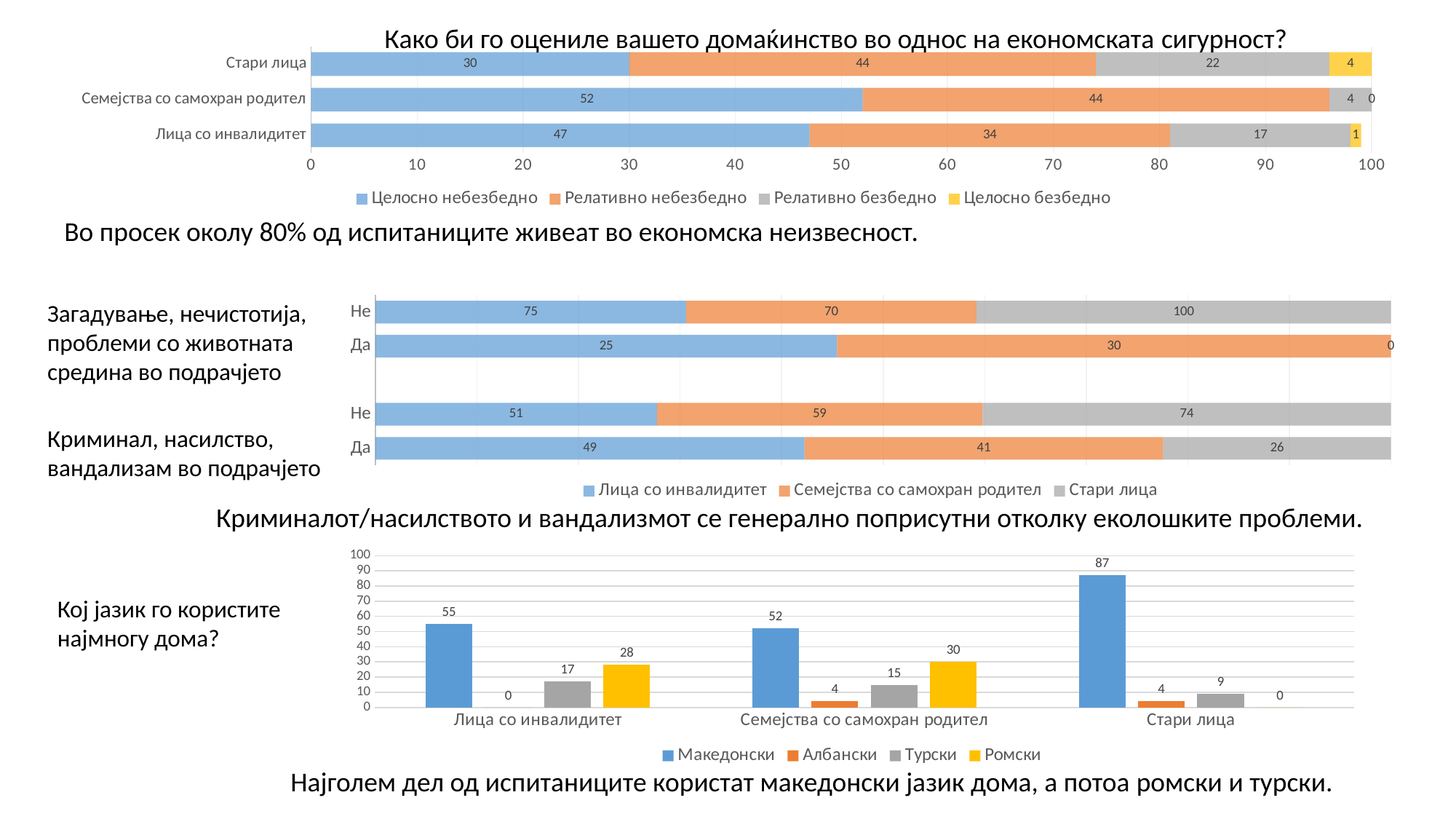
In the top chart 'Како би го оцениле вашето домаќинство во однос на економската сигурност?', how many series does the legend list? 4 In the bottom chart 'Кој јазик го користите најмногу дома?', what is the value of 'Македонски' for 'Стари лица'? 87 In the top chart 'Како би го оцениле вашето домаќинство во однос на економската сигурност?', what is the value of 'Целосно небезбедно' for 'Семејства со самохран родител'? 52 What type of chart is the bottom chart 'Кој јазик го користите најмногу дома?'? Bar chart In the middle chart, what is the value for 'Стари лица' in the 'Не' bar under 'Загадување, нечистотија, проблеми со животната средина во подрачјето'? 100 In the middle chart, which series has the highest value in the 'Не' bar under 'Криминал, насилство, вандализам во подрачјето'? Стари лица In the top chart 'Како би го оцениле вашето домаќинство во однос на економската сигурност?', what is the total of the stacked bar for 'Лица со инвалидитет'? 99 In the middle chart, what is the value for 'Семејства со самохран родител' in the 'Да' bar under 'Криминал, насилство, вандализам во подрачјето'? 41 In the top chart 'Како би го оцениле вашето домаќинство во однос на економската сигурност?', what is the value of 'Релативно безбедно' for 'Стари лица'? 22 In the bottom chart 'Кој јазик го користите најмногу дома?', how many categories are shown on the x axis? 3 In the bottom chart 'Кој јазик го користите најмногу дома?', which language has the lowest value for 'Лица со инвалидитет'? Албански In the bottom chart 'Кој јазик го користите најмногу дома?', what is the difference between 'Ромски' and 'Турски' for 'Семејства со самохран родител'? 15